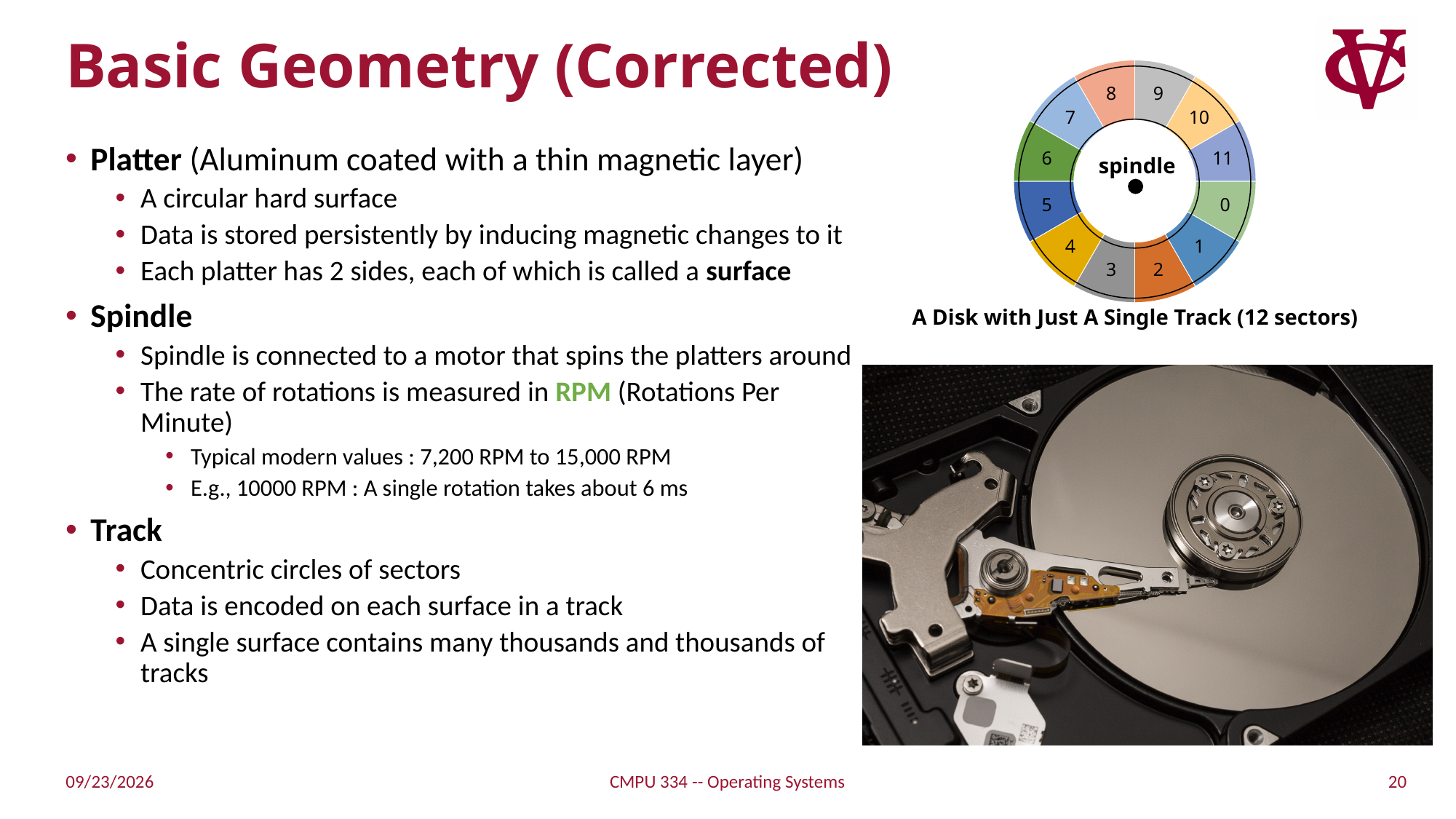
What is the highest sector number labeled on the disk diagram? 11 What label appears at the center of the disk diagram? spindle How many tracks does the disk diagram depict? 1 What is the lowest sector number labeled on the disk diagram? 0 What is the caption of the disk diagram? A Disk with Just A Single Track (12 sectors) How many sectors does the disk diagram show? 12